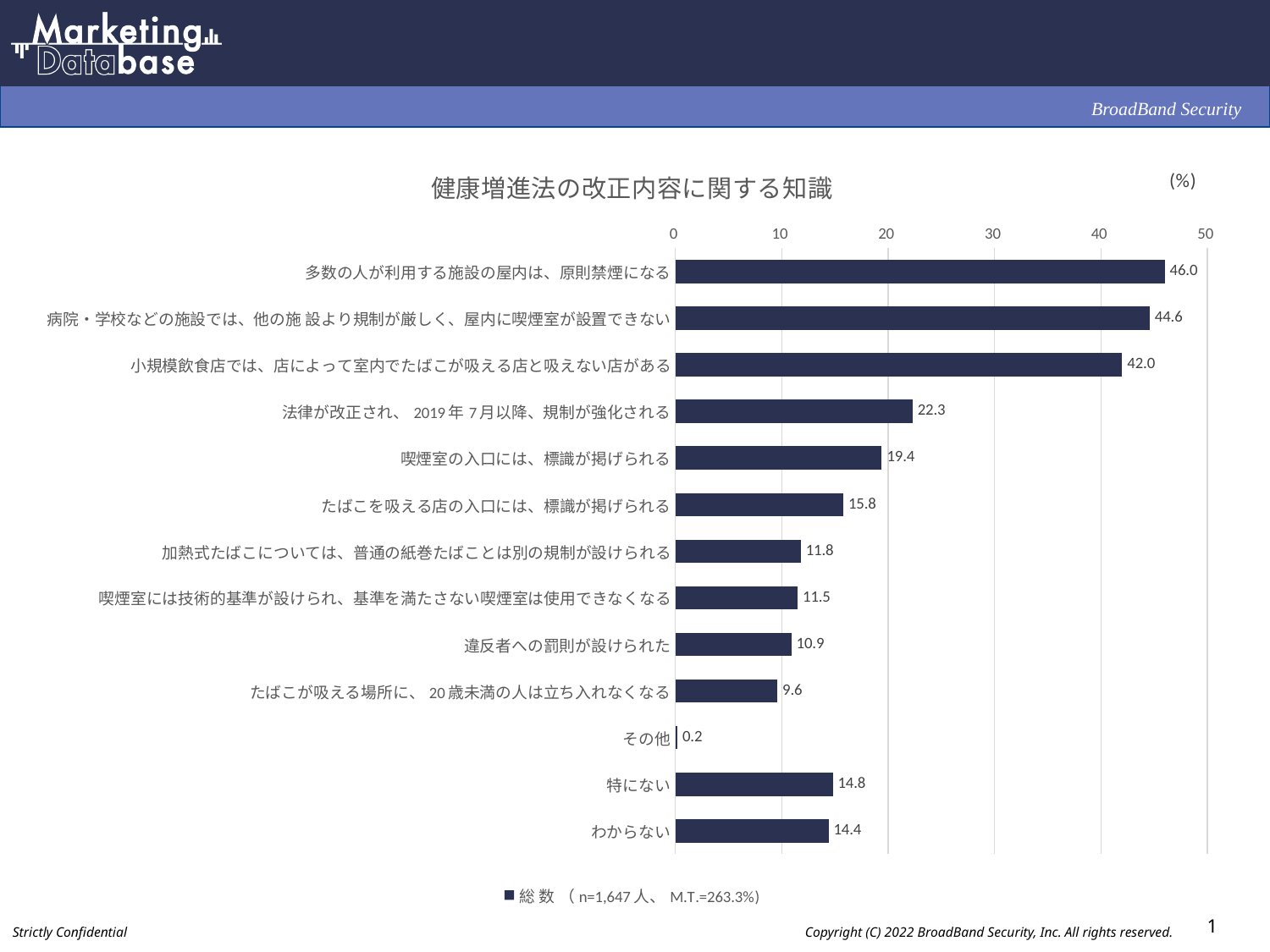
Which category has the lowest value? その他 What is the value for 多数の人が利用する施設の屋内は、原則禁煙になる? 46.0 Which category has the highest value? 多数の人が利用する施設の屋内は、原則禁煙になる What is the title of the chart? 健康増進法の改正内容に関する知識 What is the value for 法律が改正され、2019年7月以降、規制が強化される? 22.3 How many categories are shown in the chart? 13 What kind of chart is shown on the slide? bar chart Which is larger, the value for 特にない or the value for 違反者への罰則が設けられた? 特にない What is the difference between the values for 喫煙室の入口には、標識が掲げられる and たばこを吸える店の入口には、標識が掲げられる? 3.6 What is the value for わからない? 14.4 How many series does the legend list? 1 Is the value for 小規模飲食店では、店によって室内でたばこが吸える店と吸えない店がある greater or less than 40? greater